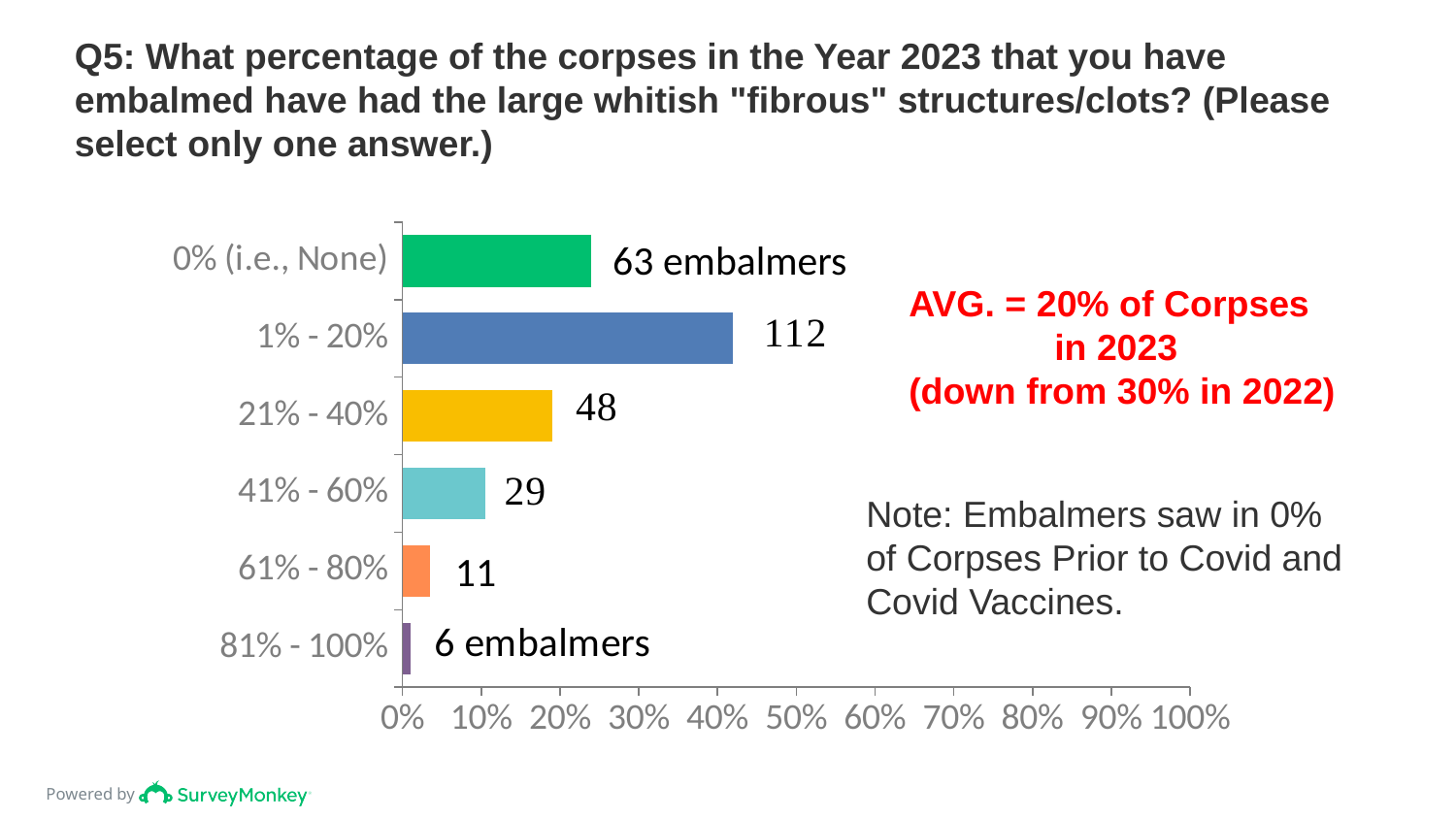
What is the data label on the bar for the "0% (i.e., None)" category? 63 embalmers What is the data label on the bar for the "21% - 40%" category? 48 Which category has more embalmers, "41% - 60%" or "61% - 80%"? 41% - 60% Which category has the lowest number of embalmers? 81% - 100% Is the bar for "41% - 60%" greater or less than 20% on the x axis? less What kind of chart is shown on the slide? Bar chart What is the data label on the bar for the "81% - 100%" category? 6 embalmers How many more embalmers chose "1% - 20%" than "21% - 40%"? 64 Which category has the highest number of embalmers? 1% - 20% What is the data label on the bar for the "41% - 60%" category? 29 How many categories are shown on the chart? 6 What is the data label on the bar for the "1% - 20%" category? 112